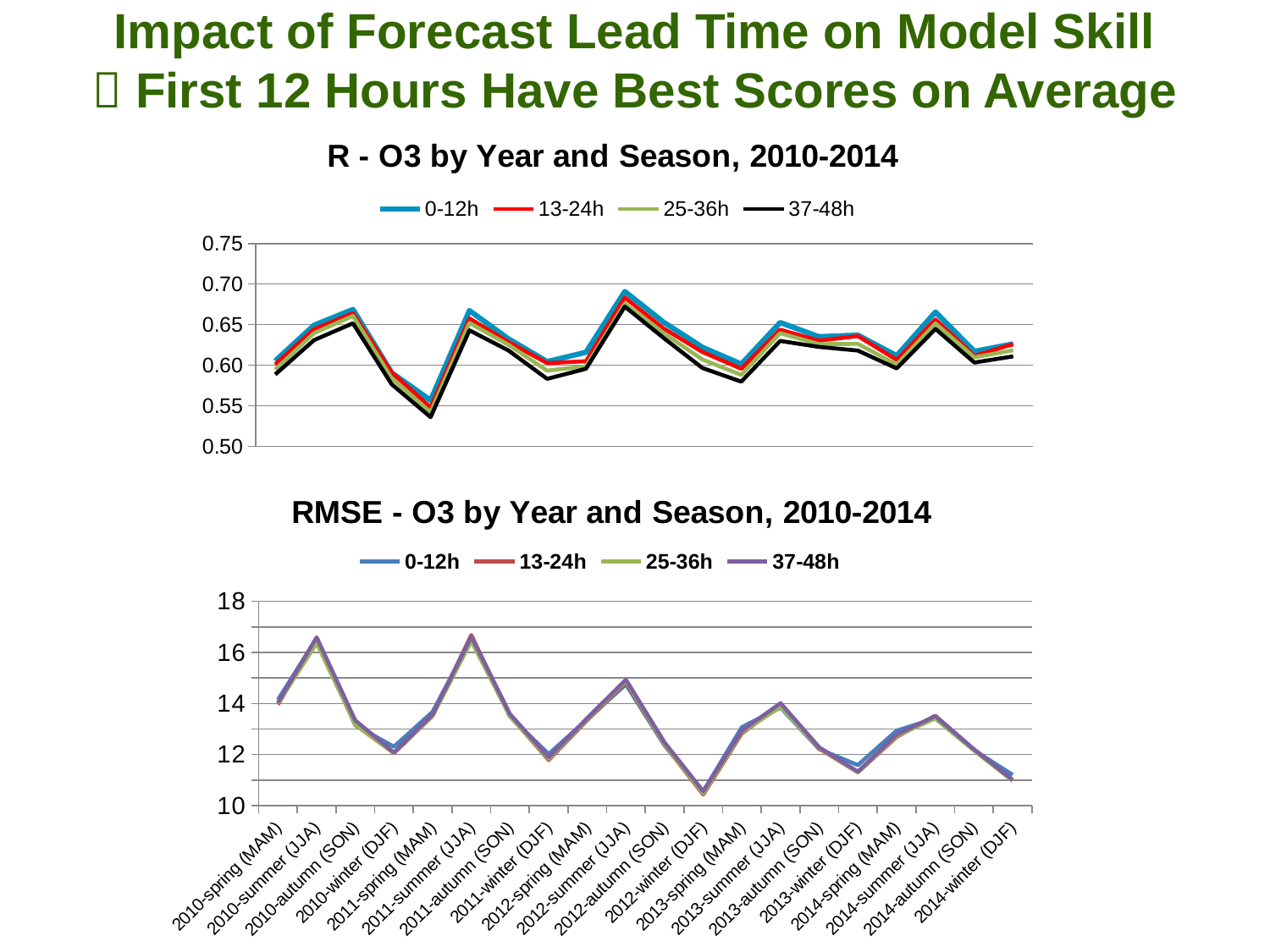
In the bottom chart "RMSE - O3 by Year and Season, 2010-2014", which has the larger RMSE: 2010-summer (JJA) or 2010-autumn (SON)? 2010-summer (JJA) In the bottom chart "RMSE - O3 by Year and Season, 2010-2014", how many year-season categories are shown on the x axis? 20 How many series does the legend of the bottom chart "RMSE - O3 by Year and Season, 2010-2014" list? 4 In the bottom chart "RMSE - O3 by Year and Season, 2010-2014", is the RMSE for 2012-winter (DJF) greater or less than 12? less In the bottom chart "RMSE - O3 by Year and Season, 2010-2014", do the summer (JJA) peaks generally rise or fall from 2010 to 2014? fall In the bottom chart "RMSE - O3 by Year and Season, 2010-2014", which category has the lowest RMSE? 2012-winter (DJF) In the bottom chart "RMSE - O3 by Year and Season, 2010-2014", is the RMSE for 2010-summer (JJA) greater or less than 16? greater What are the lowest and highest values shown on the y axis of the top chart "R - O3 by Year and Season, 2010-2014"? 0.50 and 0.75 In the bottom chart "RMSE - O3 by Year and Season, 2010-2014", which has the larger RMSE: 2012-summer (JJA) or 2013-summer (JJA)? 2012-summer (JJA) In the bottom chart "RMSE - O3 by Year and Season, 2010-2014", is the RMSE for 2014-winter (DJF) greater or less than 12? less What kind of chart is the top chart titled "R - O3 by Year and Season, 2010-2014"? line chart In the top chart "R - O3 by Year and Season, 2010-2014", which series is drawn in black? 37-48h